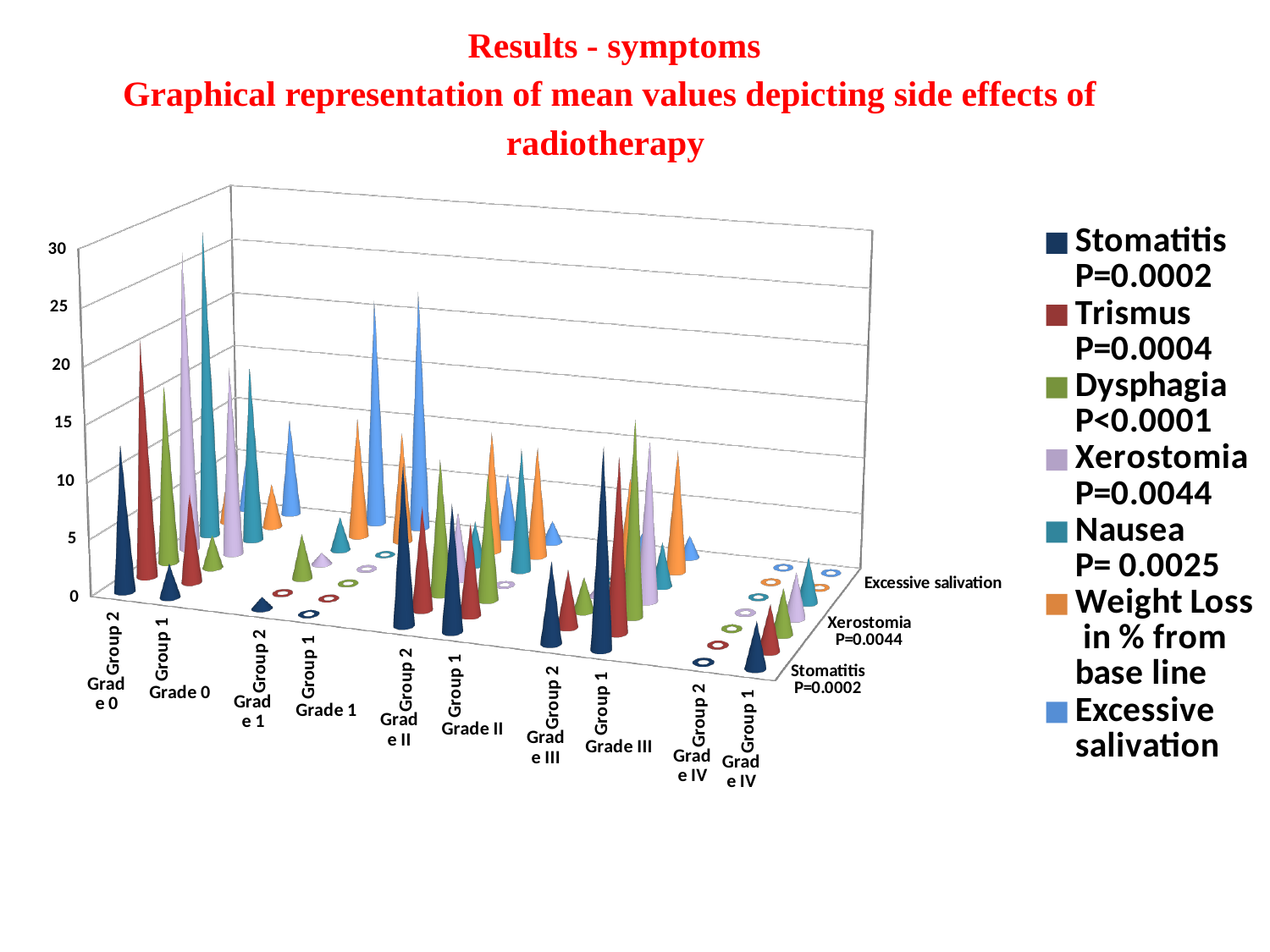
How many series does the legend list? 7 Is the value for Excessive salivation in Grade IV Group 2 greater or less than 5? less How many group categories (Group 1/Group 2 across all grades) are shown along the x axis? 10 Is the value for Stomatitis in Grade IV Group 2 greater or less than 5? less How many grade levels are shown along the x axis? 5 Which is larger for Stomatitis: Grade 0 Group 2 or Grade IV Group 2? Grade 0 Group 2 What kind of chart is shown on the slide? bar chart Is the value for Stomatitis in Grade 1 Group 2 greater or less than 5? less Which is larger for Trismus: Grade 0 Group 2 or Grade 1 Group 2? Grade 0 Group 2 What P value does the legend give for Dysphagia? P<0.0001 What is the highest tick value shown on the vertical axis? 30